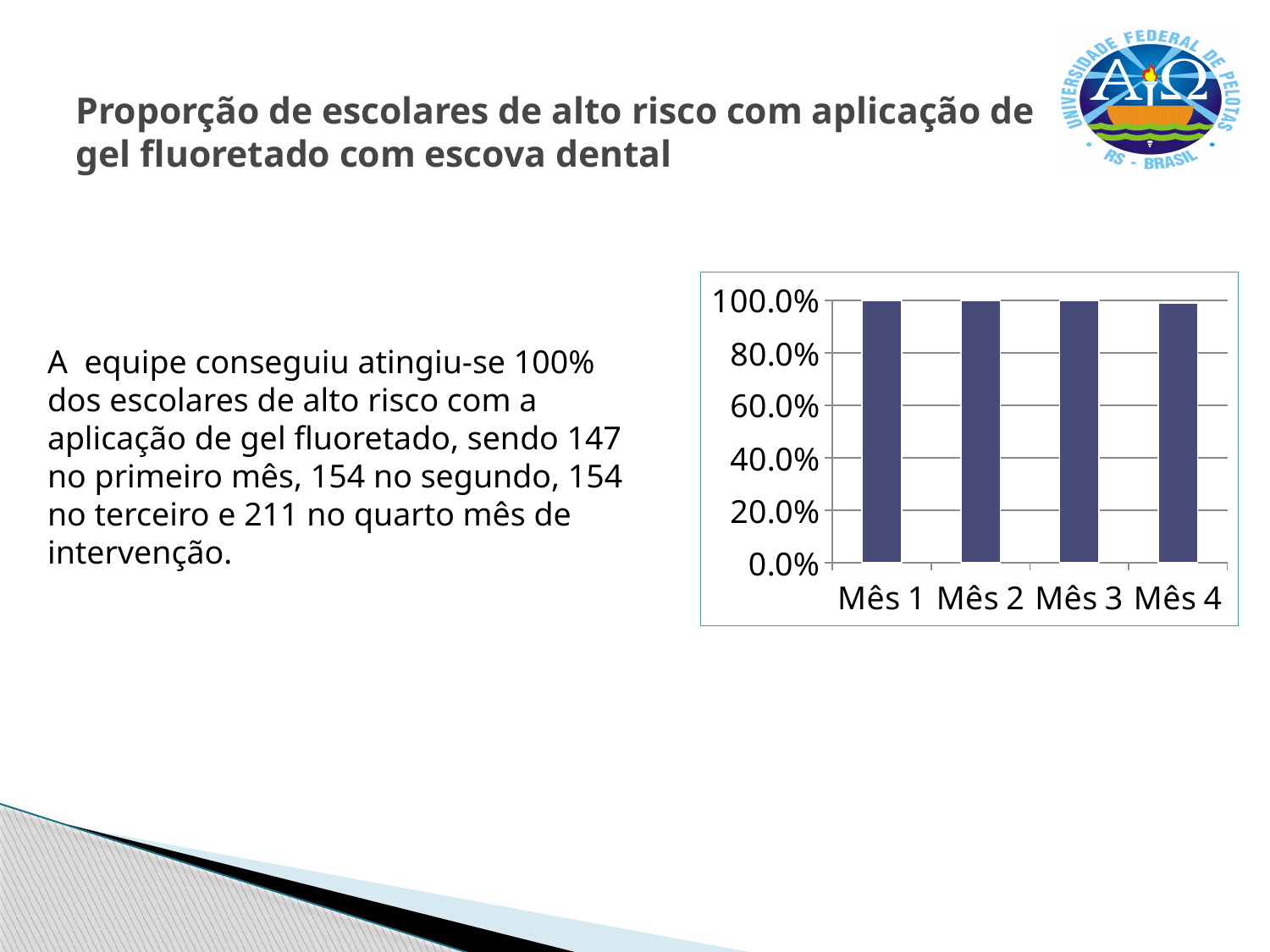
What is the label of the first category on the x axis? Mês 1 What kind of chart is shown on the slide? bar chart Is the value for Mês 4 greater or less than 60.0%? greater How many categories are plotted on the x axis of the chart? 4 Is the value for Mês 2 greater or less than 80.0%? greater What is the highest tick value shown on the y axis of the chart? 100.0%